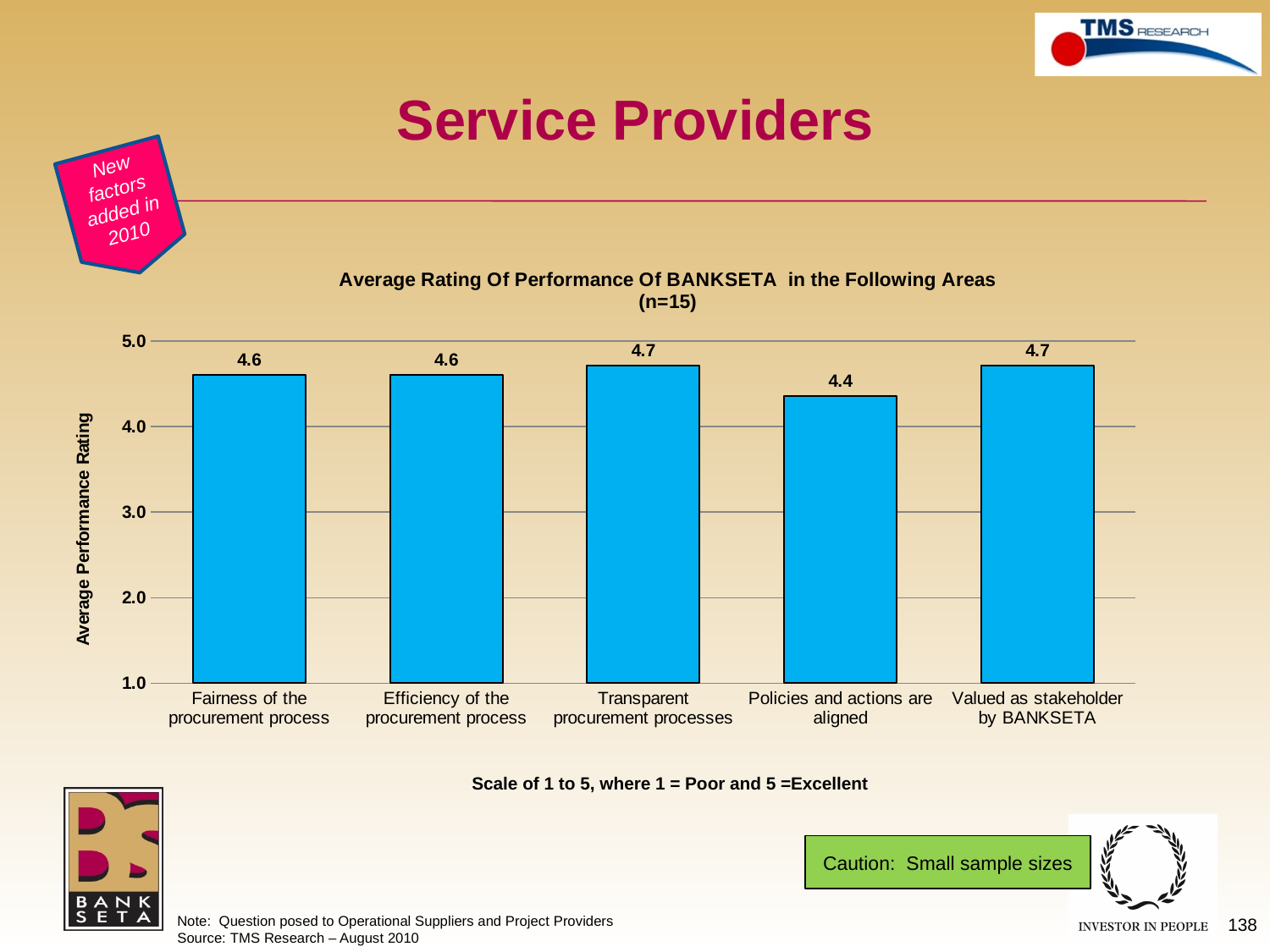
What is the difference between the rating for 'Fairness of the procurement process' and the rating for 'Valued as stakeholder by BANKSETA'? 0.1 Is the value for 'Policies and actions are aligned' greater or less than 4.0? greater What kind of chart is shown on the slide? Bar chart What is the average performance rating for 'Policies and actions are aligned'? 4.4 Which area has the lowest average performance rating? Policies and actions are aligned What is the average performance rating for 'Valued as stakeholder by BANKSETA'? 4.7 Which has a higher rating: 'Efficiency of the procurement process' or 'Transparent procurement processes'? Transparent procurement processes What is the average performance rating for 'Fairness of the procurement process'? 4.6 What is the difference between the rating for 'Transparent procurement processes' and the rating for 'Policies and actions are aligned'? 0.3 How many areas are shown in the chart? 5 What is the label of the vertical axis? Average Performance Rating What is the sample size (n) stated in the chart title? 15